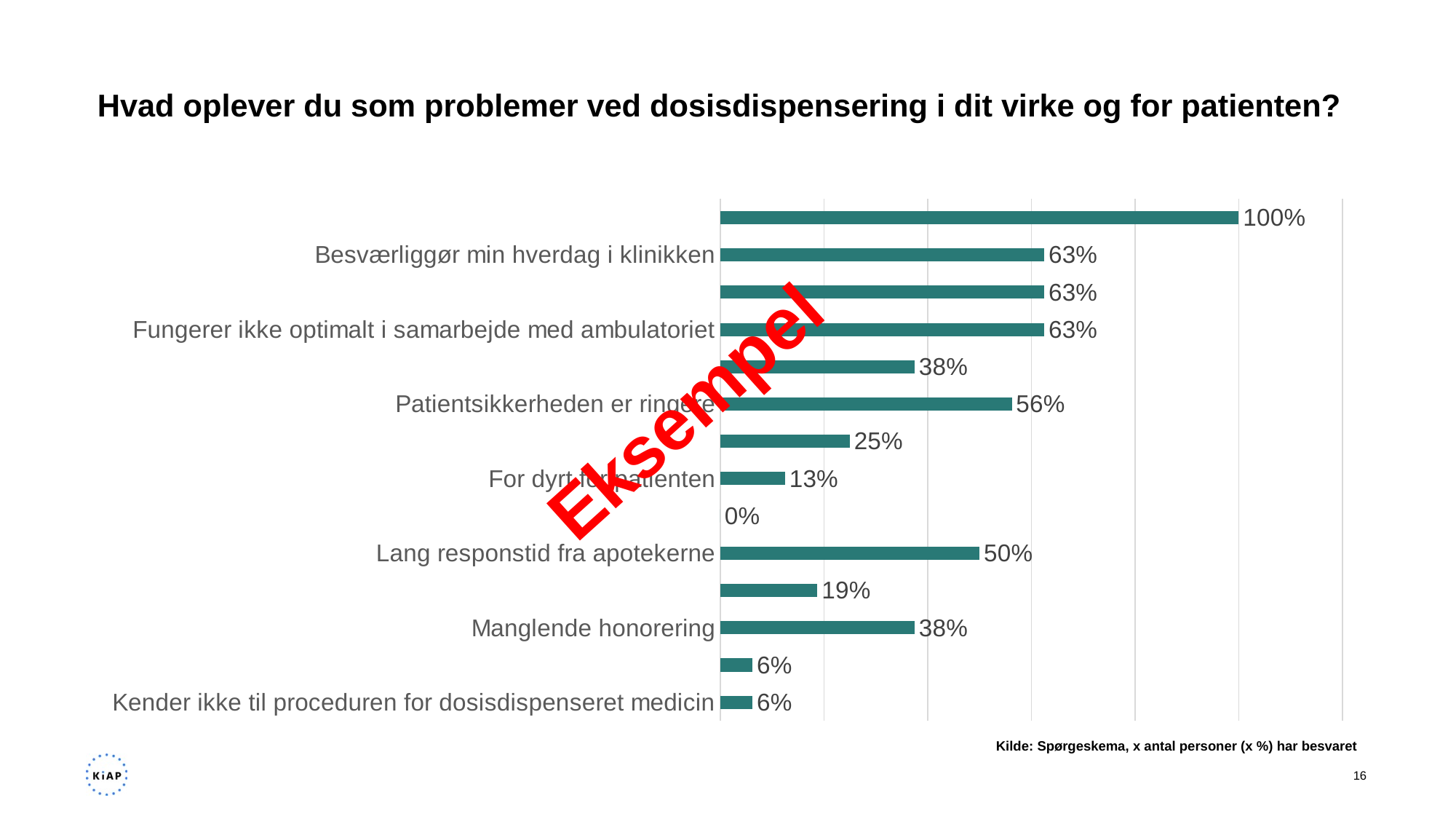
What is the value for "Lang responstid fra apotekerne"? 50% What is the difference between the value for "Besværliggør min hverdag i klinikken" and the value for "Lang responstid fra apotekerne"? 13 percentage points What is the lowest value shown on the chart? 0% What word is written in red diagonally across the chart? Eksempel What kind of chart is shown on the slide? bar chart What is the value for "Kender ikke til proceduren for dosisdispenseret medicin"? 6% What is the highest value shown on the chart? 100% Which is larger: the value for "Lang responstid fra apotekerne" or the value for "Manglende honorering"? Lang responstid fra apotekerne How many bars are plotted on the chart? 14 What is the value for "Manglende honorering"? 38% What is the value for "Besværliggør min hverdag i klinikken"? 63% What is the value for "Fungerer ikke optimalt i samarbejde med ambulatoriet"? 63%